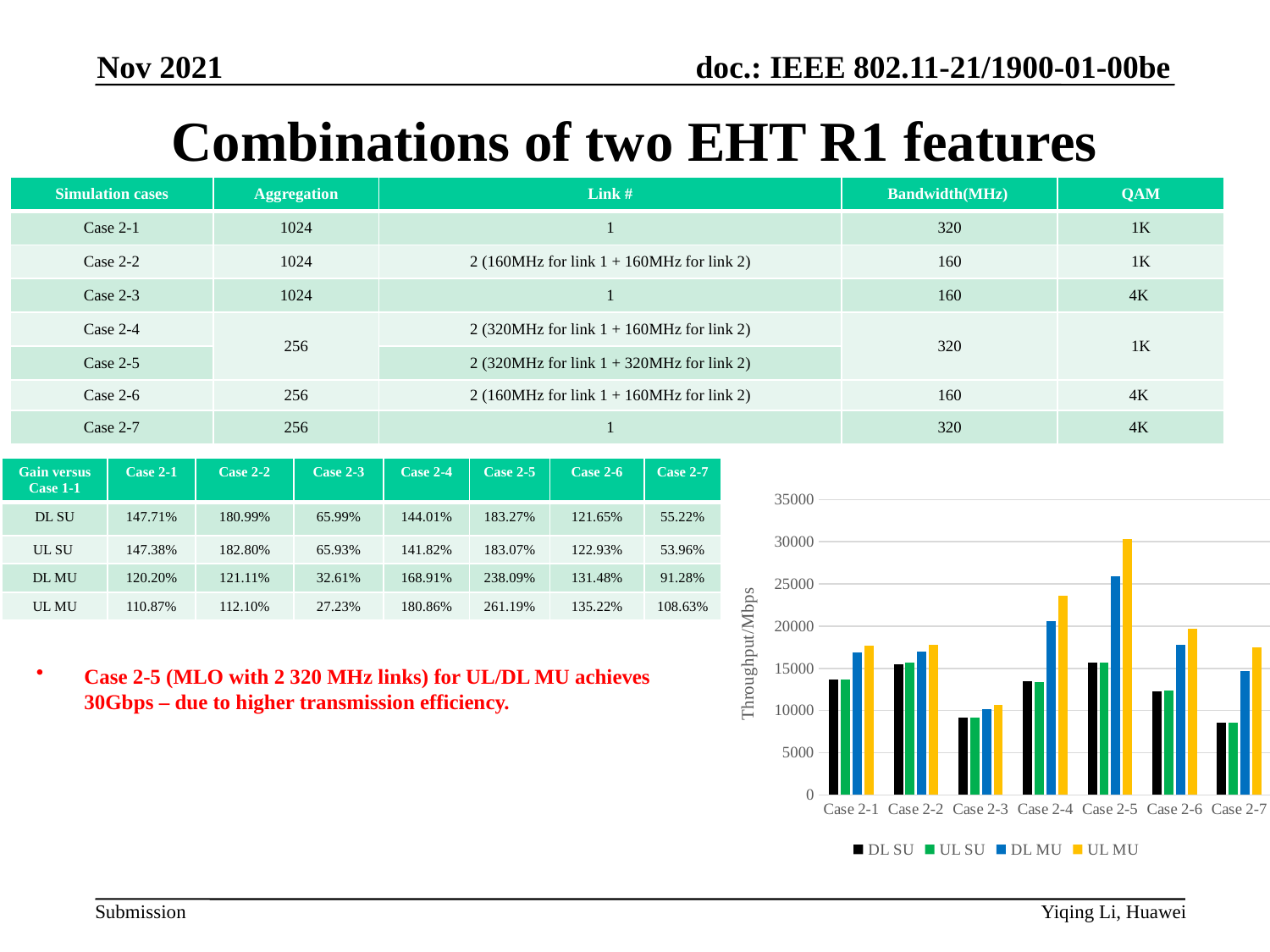
Which series in the chart is drawn in yellow? UL MU Is the UL MU value for Case 2-5 greater or less than 25000? greater How many simulation cases are plotted along the x axis of the chart? 7 Which case has the lowest UL MU throughput in the chart? Case 2-3 Which is larger in the chart: the DL MU value for Case 2-4 or the DL MU value for Case 2-2? Case 2-4 Which is larger in the chart: the UL MU value for Case 2-7 or the UL MU value for Case 2-3? Case 2-7 Is the DL SU value for Case 2-3 greater or less than 10000? less What kind of chart is shown on the slide? bar chart Is the UL MU value for Case 2-4 greater or less than 20000? greater What is the label of the vertical axis of the chart? Throughput/Mbps Which case has the highest UL MU throughput in the chart? Case 2-5 How many series does the chart legend list? 4